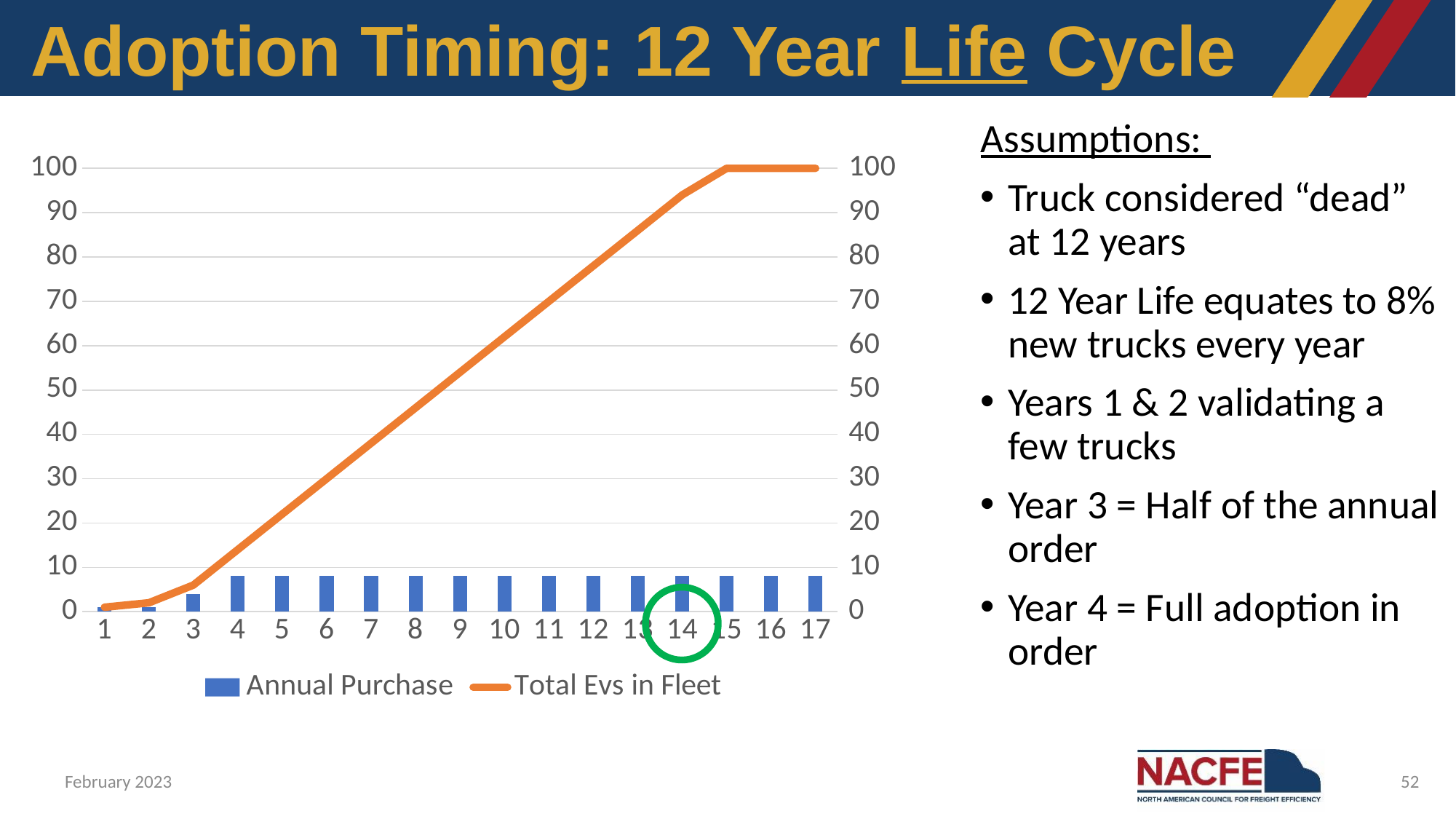
Does the Total Evs in Fleet line rise or fall from year 1 to year 15? Rise How many years are shown along the x axis of the chart? 17 How many series does the chart legend list? 2 Which year on the x axis is highlighted with a green circle? 14 Is the Annual Purchase value at year 10 greater or less than 10? less Which series is drawn as an orange line? Total Evs in Fleet Which is larger, the Annual Purchase at year 3 or at year 4? Year 4 Is the Total Evs in Fleet value at year 6 greater or less than 20? greater Is the Total Evs in Fleet value at year 10 greater or less than 50? greater What is the value of Total Evs in Fleet at year 17? 100 What is the value of Total Evs in Fleet at year 15? 100 What type of chart is shown on the slide? Combined bar and line chart